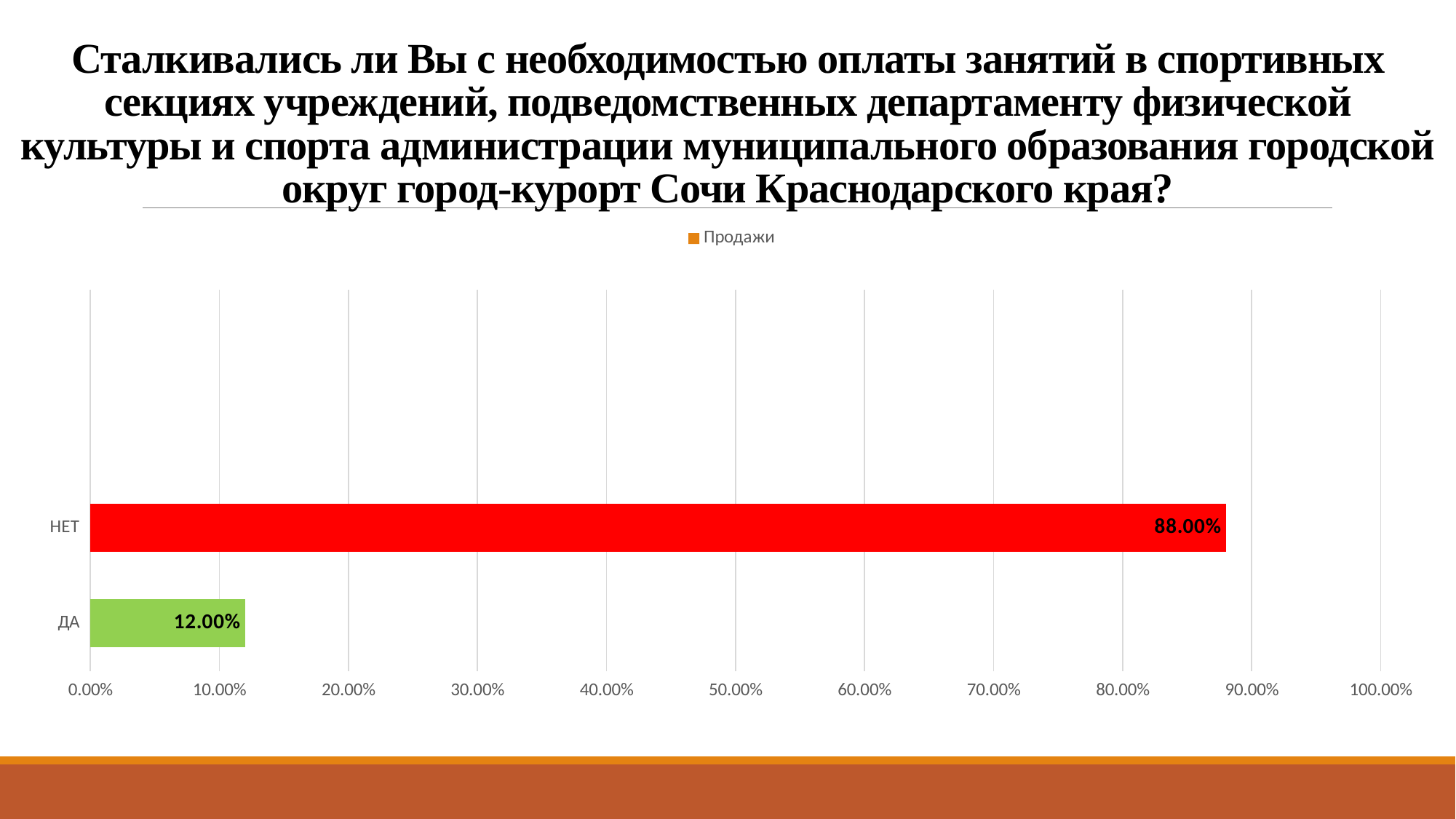
What is the value for ДА? 12.00% Is the value for ДА greater or less than 20.00%? less How many categories are shown in the chart? 2 Is the value for НЕТ greater or less than 80.00%? greater Which category has the highest value? НЕТ How many series does the legend list? 1 What is the difference between the values for НЕТ and ДА? 76.00% What kind of chart is shown on the slide? bar chart What series name is shown in the legend? Продажи Which is larger, the value for ДА or the value for НЕТ? НЕТ What is the value for НЕТ? 88.00% Which category has the lowest value? ДА